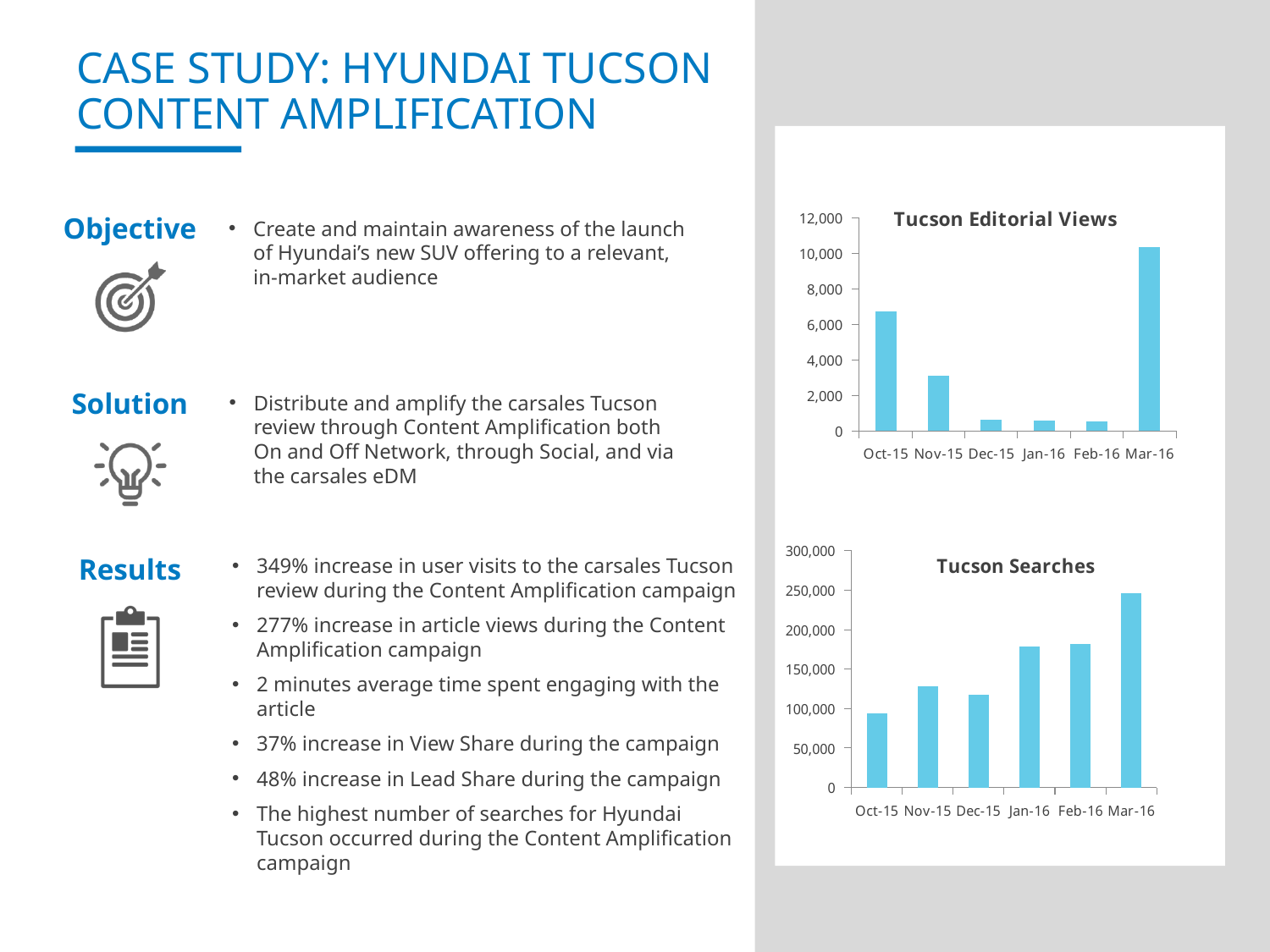
How many months are shown on the x axis of the Tucson Editorial Views chart? 6 What is the title of the lower chart on the slide? Tucson Searches In the Tucson Searches chart, is the value for Oct-15 greater or less than 100,000? less In the Tucson Editorial Views chart, is the value for Oct-15 greater or less than 6,000? greater In the Tucson Editorial Views chart, which month has the highest value? Mar-16 What kind of chart is the Tucson Editorial Views chart? bar chart In the Tucson Searches chart, is the value for Mar-16 greater or less than 200,000? greater In the Tucson Searches chart, which is larger, the value for Oct-15 or Nov-15? Nov-15 In the Tucson Editorial Views chart, which is larger, the value for Oct-15 or Nov-15? Oct-15 In the Tucson Searches chart, which month has the highest value? Mar-16 In the Tucson Searches chart, which month has the lowest value? Oct-15